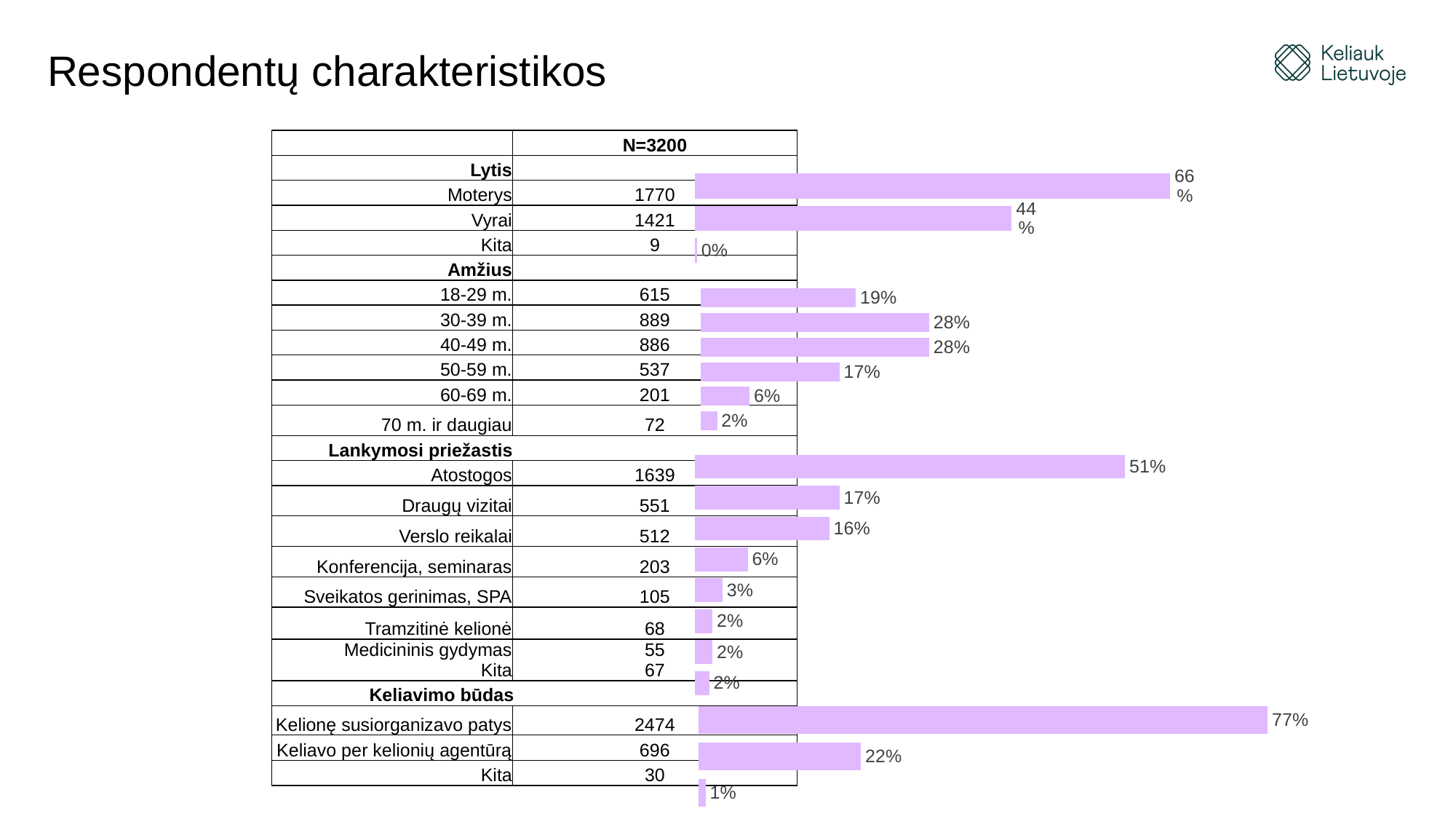
In the Keliavimo būdas section of the chart, which category has the highest percentage? Kelionę susiorganizavo patys In the Lankymosi priežastis section of the chart, what is the difference in percentage points between Atostogos and Draugų vizitai? 34 In the Lytis section of the chart, what is the difference in percentage points between Moterys and Vyrai? 22 What is the title of the slide containing the chart? Respondentų charakteristikos In the Amžius section of the chart, which age group has the lowest percentage? 70 m. ir daugiau In the Lankymosi priežastis section of the chart, what percentage is shown for Atostogos? 51% What type of chart is used on the slide? Bar chart In the Amžius section of the chart, what percentage is shown for 18-29 m.? 19% In the Keliavimo būdas section of the chart, what percentage is shown for Keliavo per kelionių agentūrą? 22% In the Lankymosi priežastis section of the chart, which is larger: Verslo reikalai or Konferencija, seminaras? Verslo reikalai In the Lytis section of the chart, what percentage is shown for Moterys? 66% How many age groups are plotted in the Amžius section of the chart? 6